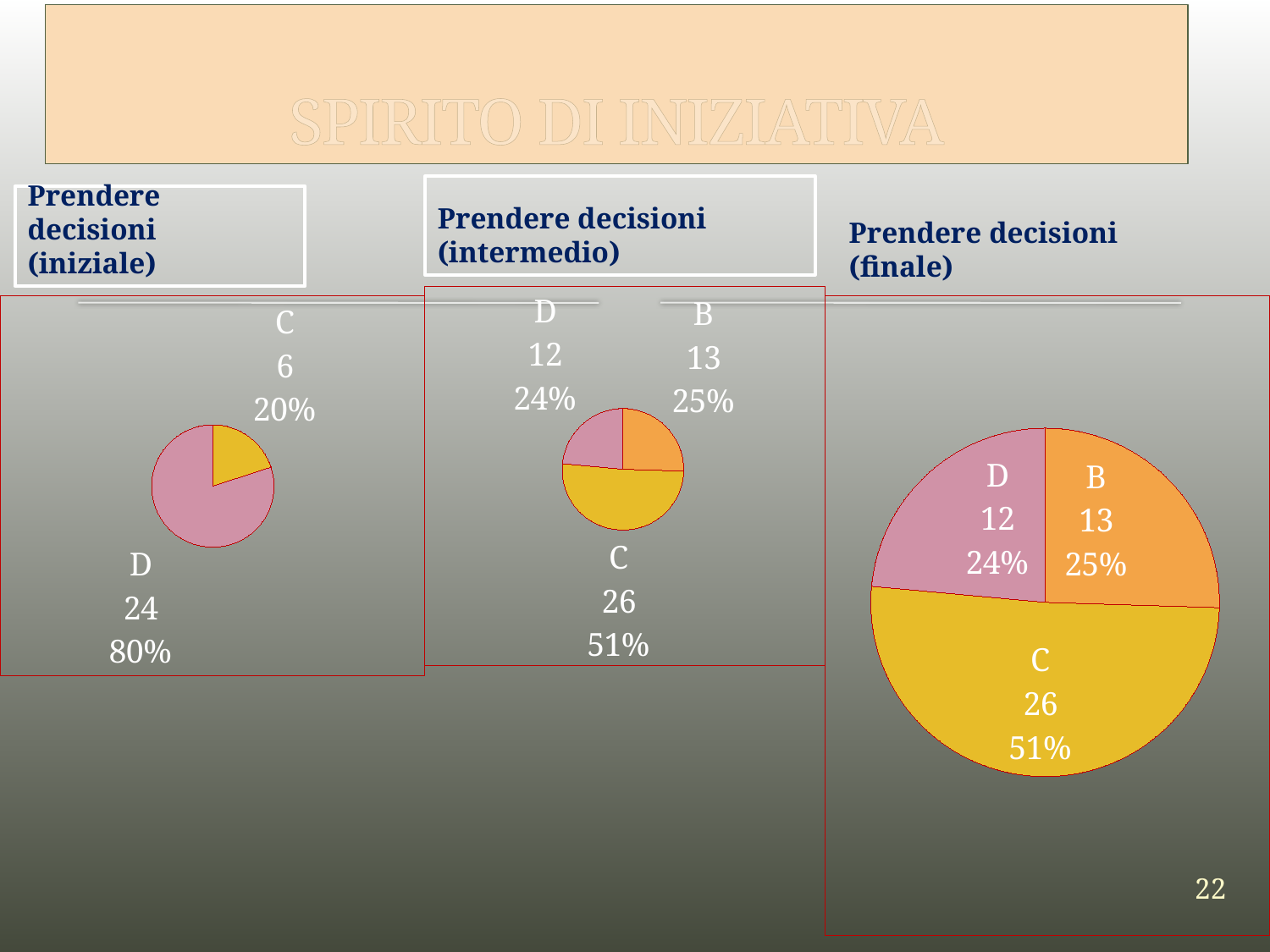
In the 'Prendere decisioni (intermedio)' chart, which category has the largest slice? C In the 'Prendere decisioni (iniziale)' chart, what share of the pie does C have? 20% In the 'Prendere decisioni (intermedio)' chart, what is the value for B? 13 In the 'Prendere decisioni (iniziale)' chart, what is the difference between the values for D and C? 18 In the 'Prendere decisioni (iniziale)' chart, what is the value for D? 24 In the 'Prendere decisioni (finale)' chart, what is the total of the values for B, C and D? 51 In the 'Prendere decisioni (finale)' chart, how many slices are there? 3 In the 'Prendere decisioni (finale)' chart, what is the value for C? 26 In the 'Prendere decisioni (intermedio)' chart, what share of the pie does D have? 24% In the 'Prendere decisioni (finale)' chart, which is larger, the value for B or the value for D? B What kind of chart is used for 'Prendere decisioni (iniziale)'? pie chart In the 'Prendere decisioni (iniziale)' chart, how many slices are there? 2